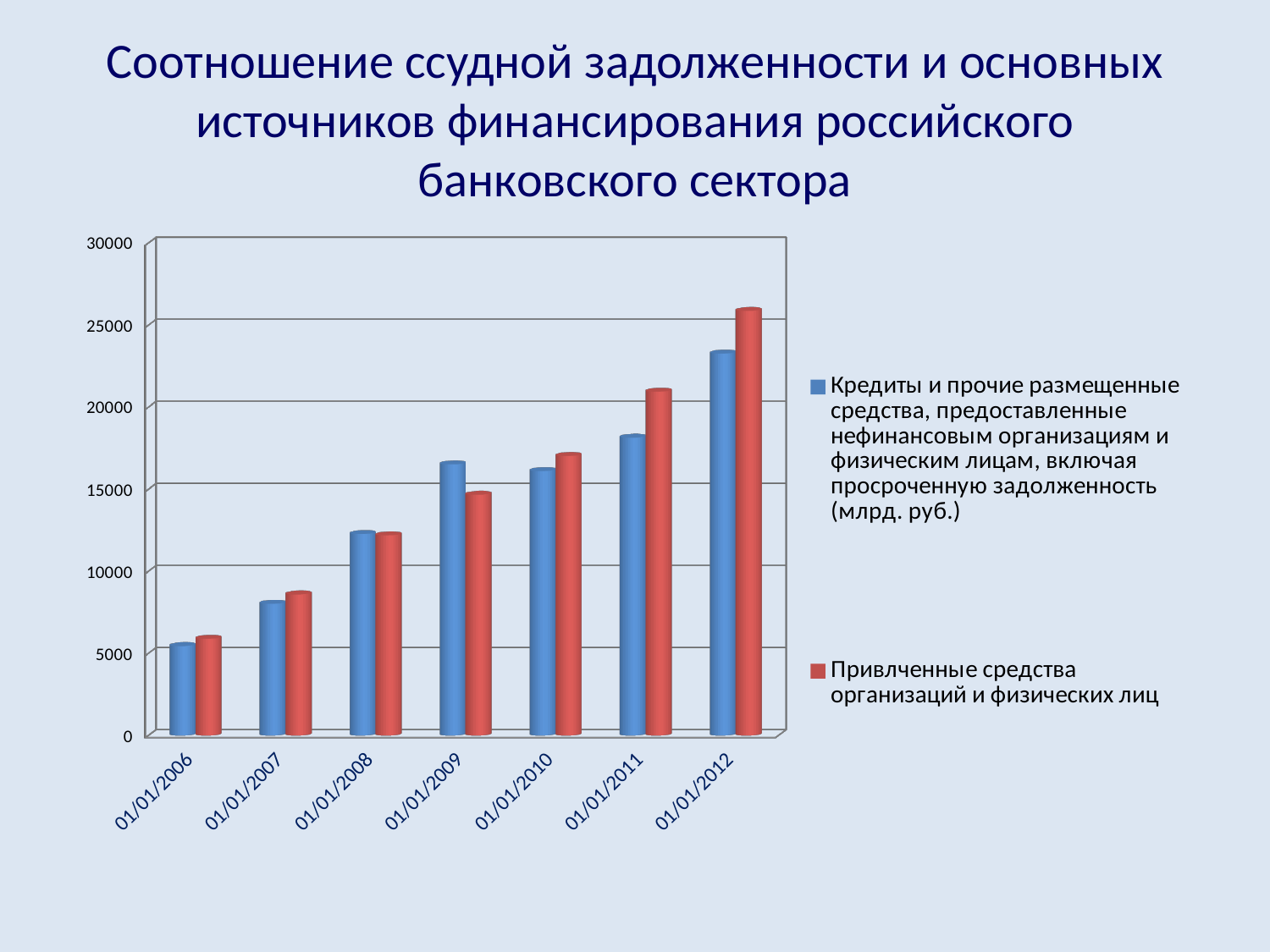
Is the value for 'Кредиты и прочие размещенные средства...' on 01/01/2010 greater or less than 15000? greater On 01/01/2009, which series has the larger value: 'Кредиты и прочие размещенные средства...' or 'Привлченные средства организаций и физических лиц'? Кредиты и прочие размещенные средства... How many dates are shown on the x axis of the chart? 7 What colour represents 'Привлченные средства организаций и физических лиц' in the chart? Red On 01/01/2011, which series has the larger value: 'Кредиты и прочие размещенные средства...' or 'Привлченные средства организаций и физических лиц'? Привлченные средства организаций и физических лиц On which date is the value for 'Привлченные средства организаций и физических лиц' highest? 01/01/2012 Is the value for 'Привлченные средства организаций и физических лиц' on 01/01/2011 greater or less than 20000? greater What kind of chart is shown on the slide? Bar chart Does the value for 'Привлченные средства организаций и физических лиц' rise or fall from 01/01/2006 to 01/01/2012? Rise On which date is the value for 'Кредиты и прочие размещенные средства...' lowest? 01/01/2006 How many series does the chart's legend list? 2 Is the value for 'Кредиты и прочие размещенные средства...' on 01/01/2012 greater or less than 20000? greater